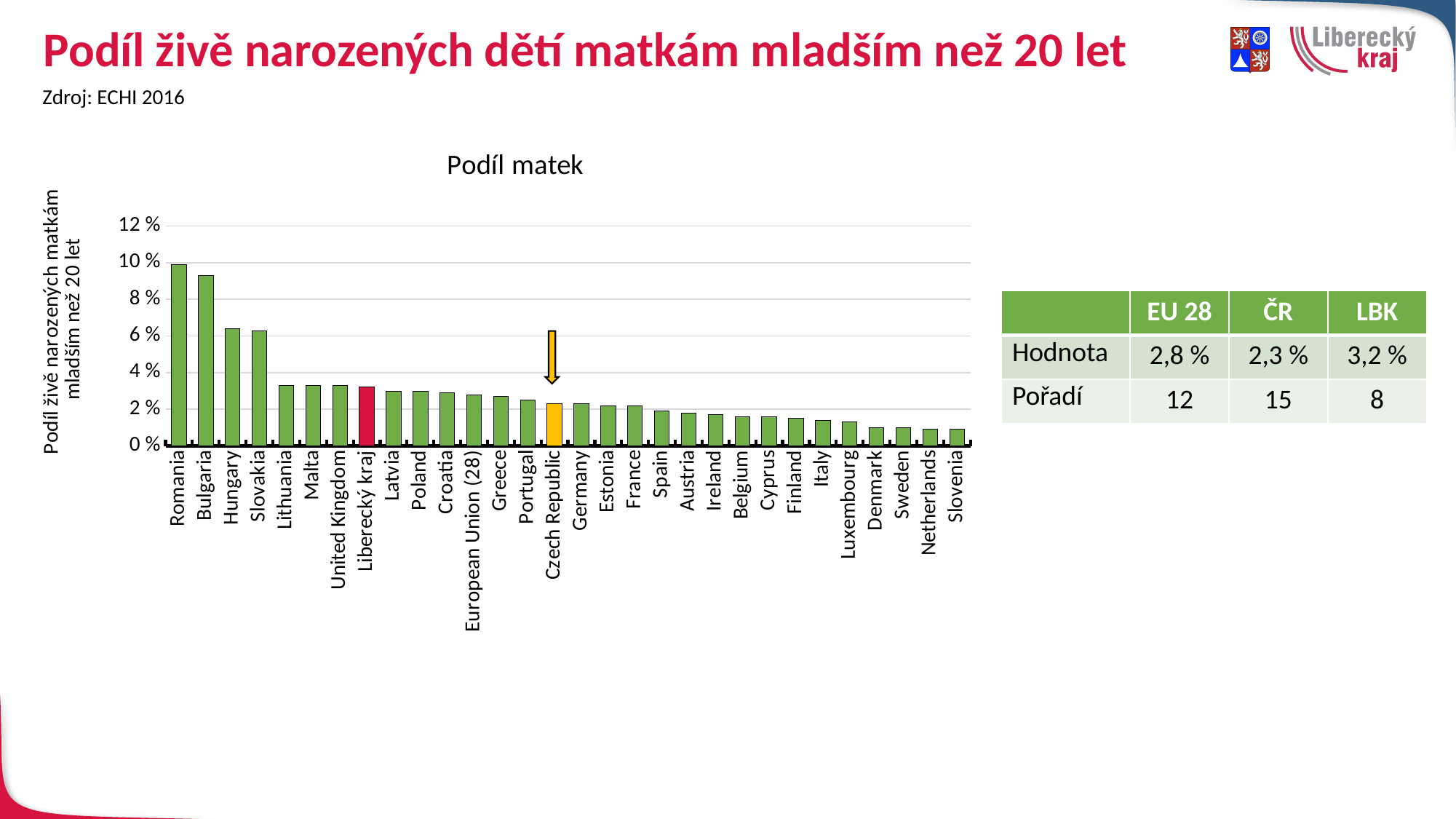
Which category has the highest value in the chart? Romania Which has the larger value, Lithuania or Spain? Lithuania How many categories (countries/regions) are plotted in the chart? 30 What is the title of the chart? Podíl matek Is the value for Hungary greater or less than 6 %? greater What kind of chart is shown on the slide? bar chart According to the table next to the chart, what is the value for the Czech Republic (ČR)? 2,3 % Do the values rise or fall from left to right along the x axis? fall Is the value for Lithuania greater or less than 4 %? less Is the value for Slovenia greater or less than 2 %? less According to the table next to the chart, what is the difference between the value for LBK and the value for ČR? 0,9 %